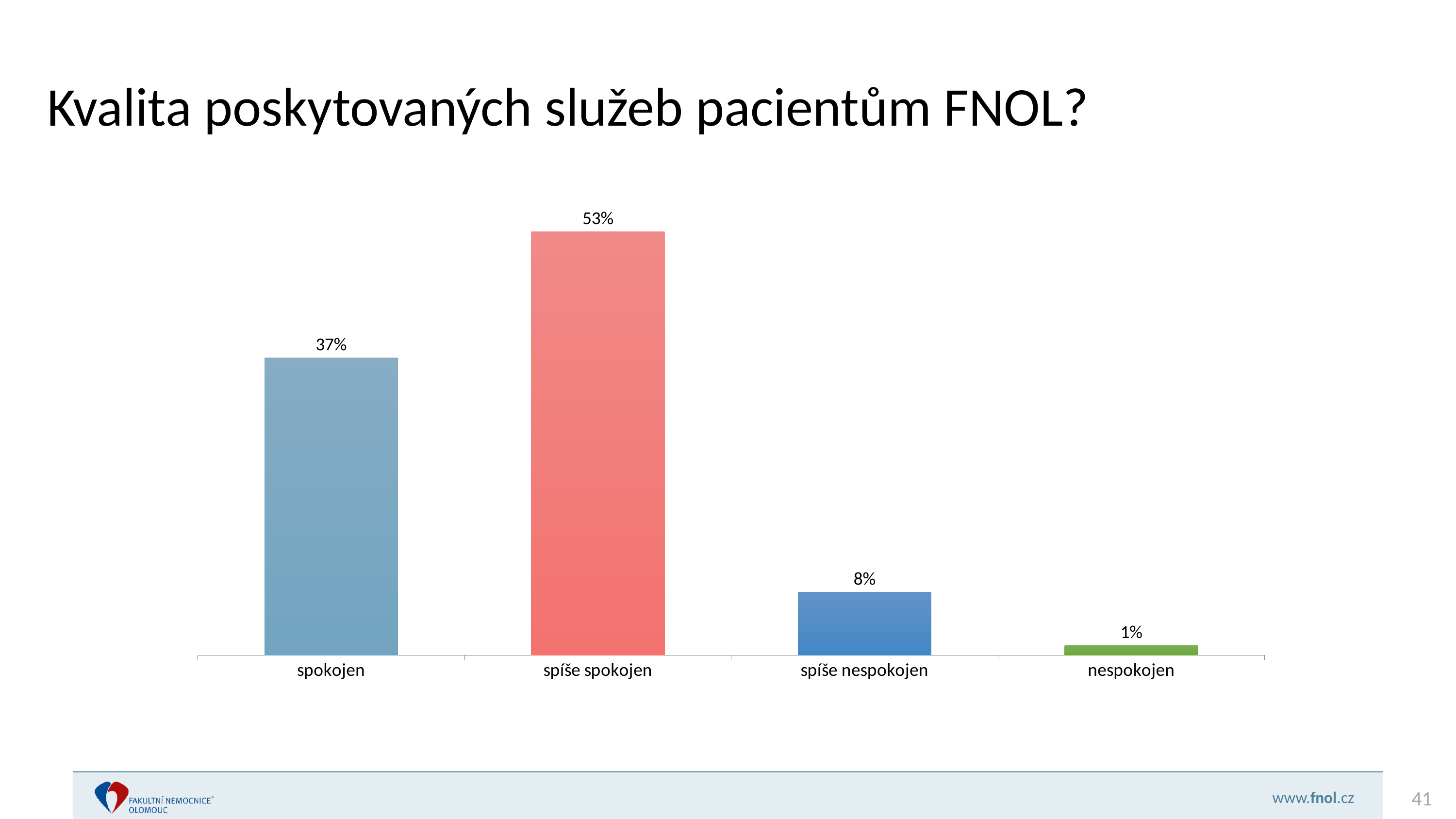
What is the value for "spíše spokojen"? 53% What is the value for "nespokojen"? 1% What kind of chart is shown on the slide? bar chart What is the difference between the values for "spíše spokojen" and "spokojen"? 16% Which category has the highest value? spíše spokojen Which is larger, the value for "spokojen" or the value for "spíše nespokojen"? spokojen Which category has the lowest value? nespokojen How many categories are shown in the chart? 4 What is the value for "spíše nespokojen"? 8% What is the title of the slide containing the chart? Kvalita poskytovaných služeb pacientům FNOL? What is the value for "spokojen"? 37% What is the difference between the values for "spíše nespokojen" and "nespokojen"? 7%